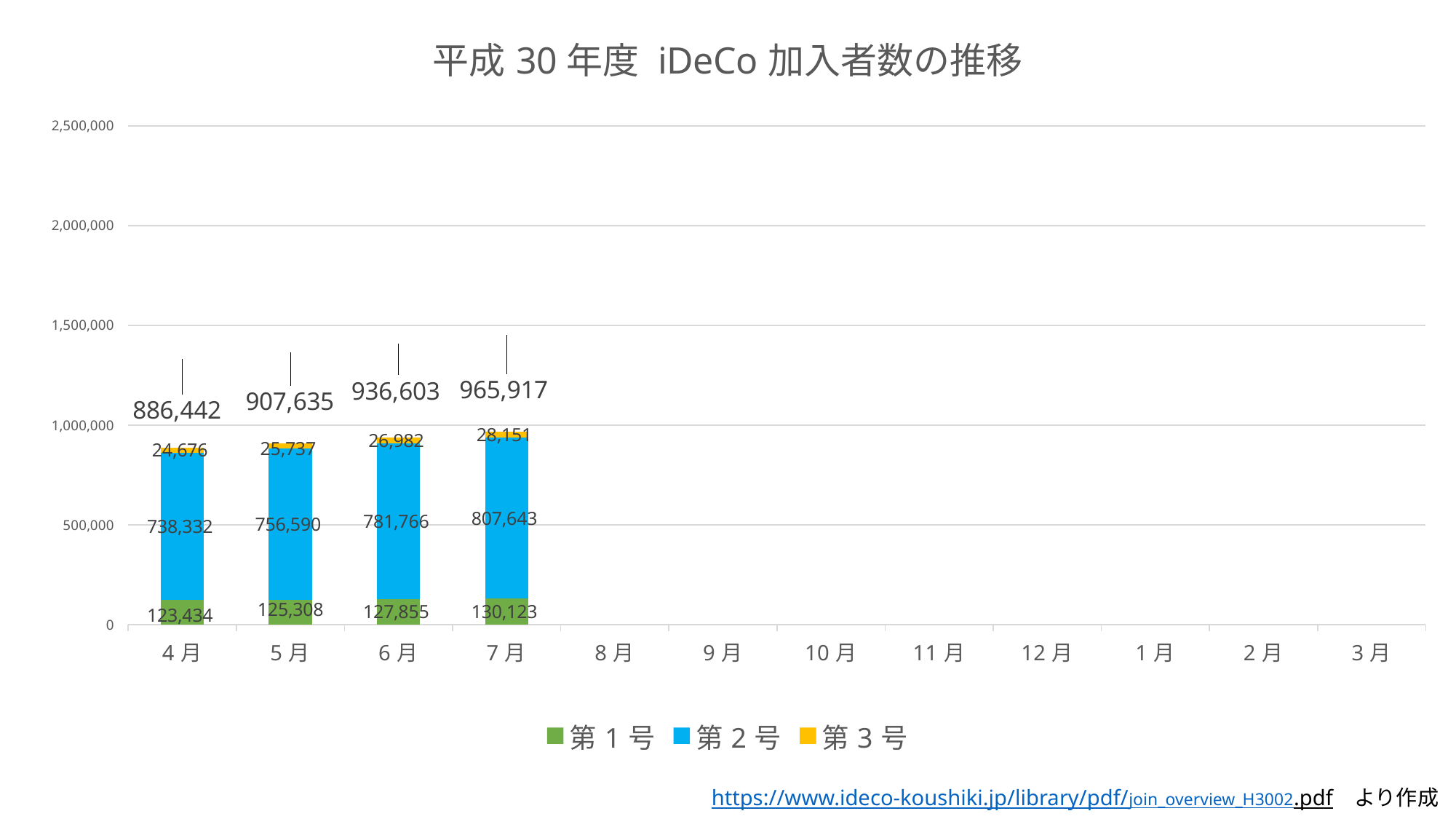
What is the difference between the 第2号 values for 7月 and 4月? 69,311 What is the total of the stacked bar for 5月? 907,635 What is the value of 第3号 for 6月? 26,982 Is the total for 7月 greater or less than 1,000,000? less What kind of chart is shown on the slide? Stacked bar chart How many series does the legend list? 3 Which month has the lowest value for 第2号 among the months with data? 4月 What is the value of 第2号 for 4月? 738,332 Do the total values rise or fall from 4月 to 7月? rise What is the value of 第1号 for 7月? 130,123 Which month has the highest total number of iDeCo subscribers among the months with data? 7月 Which is larger, the 第1号 value for 6月 or the 第3号 value for 6月? 第1号 for 6月